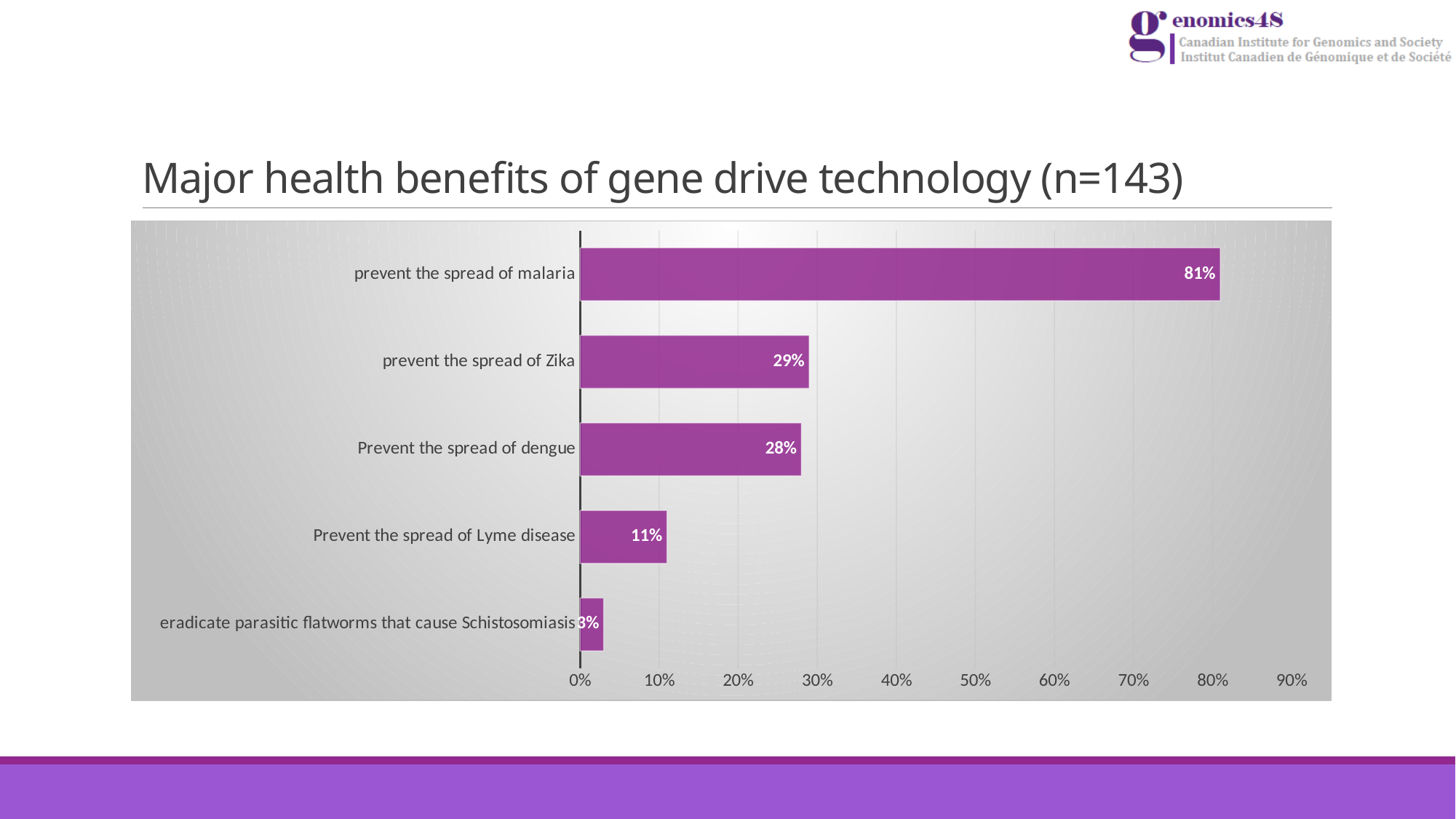
Is the value for 'prevent the spread of malaria' greater or less than 70%? greater How many health benefit categories are shown in the chart? 5 What is the value for 'Prevent the spread of Lyme disease'? 11% What is the difference in percentage points between preventing the spread of malaria and preventing the spread of Zika? 52 What percentage of respondents cited preventing the spread of malaria as a major health benefit? 81% Which is larger: the value for preventing the spread of dengue or the value for preventing the spread of Lyme disease? Prevent the spread of dengue What is the title of the chart on the slide? Major health benefits of gene drive technology (n=143) Which health benefit has the lowest percentage? eradicate parasitic flatworms that cause Schistosomiasis What is the value for 'prevent the spread of Zika'? 29% What is the value for 'eradicate parasitic flatworms that cause Schistosomiasis'? 3% What type of chart is shown on the slide? bar chart Which health benefit has the highest percentage? prevent the spread of malaria